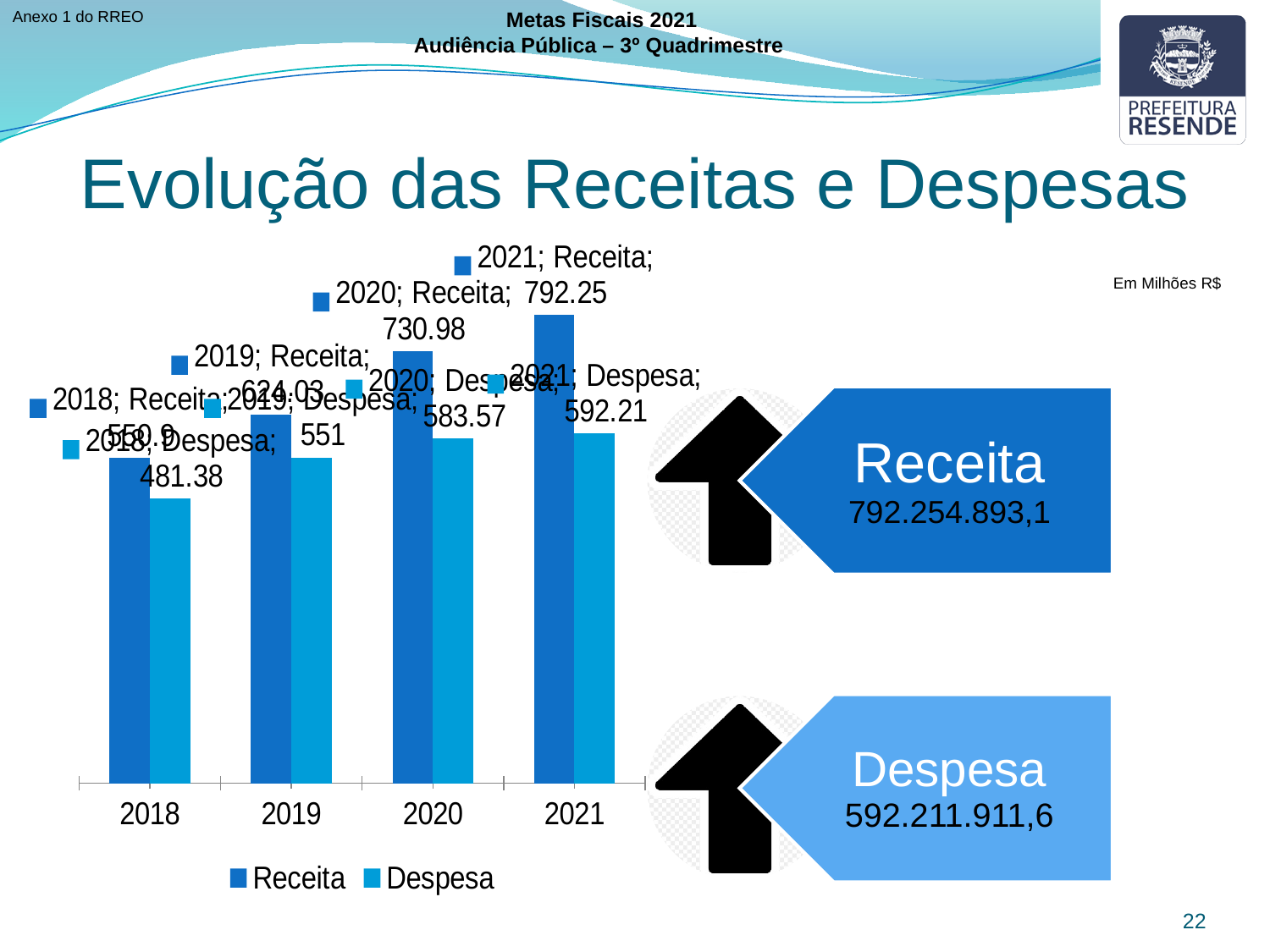
Which year has the highest Receita value? 2021 How many series does the chart legend list? 2 What is the Receita value for 2019? 624.03 What is the difference between Receita and Despesa in 2021? 200.04 What is the Despesa value for 2020? 583.57 What unit is stated for the chart values? Em Milhões R$ What is the Despesa value for 2021? 592.21 How many years are shown on the x axis of the chart? 4 What is the Receita value for 2021? 792.25 Does the Receita series rise or fall from 2018 to 2021? rise What type of chart is shown on the slide? bar chart Which year has the lowest Despesa value? 2018